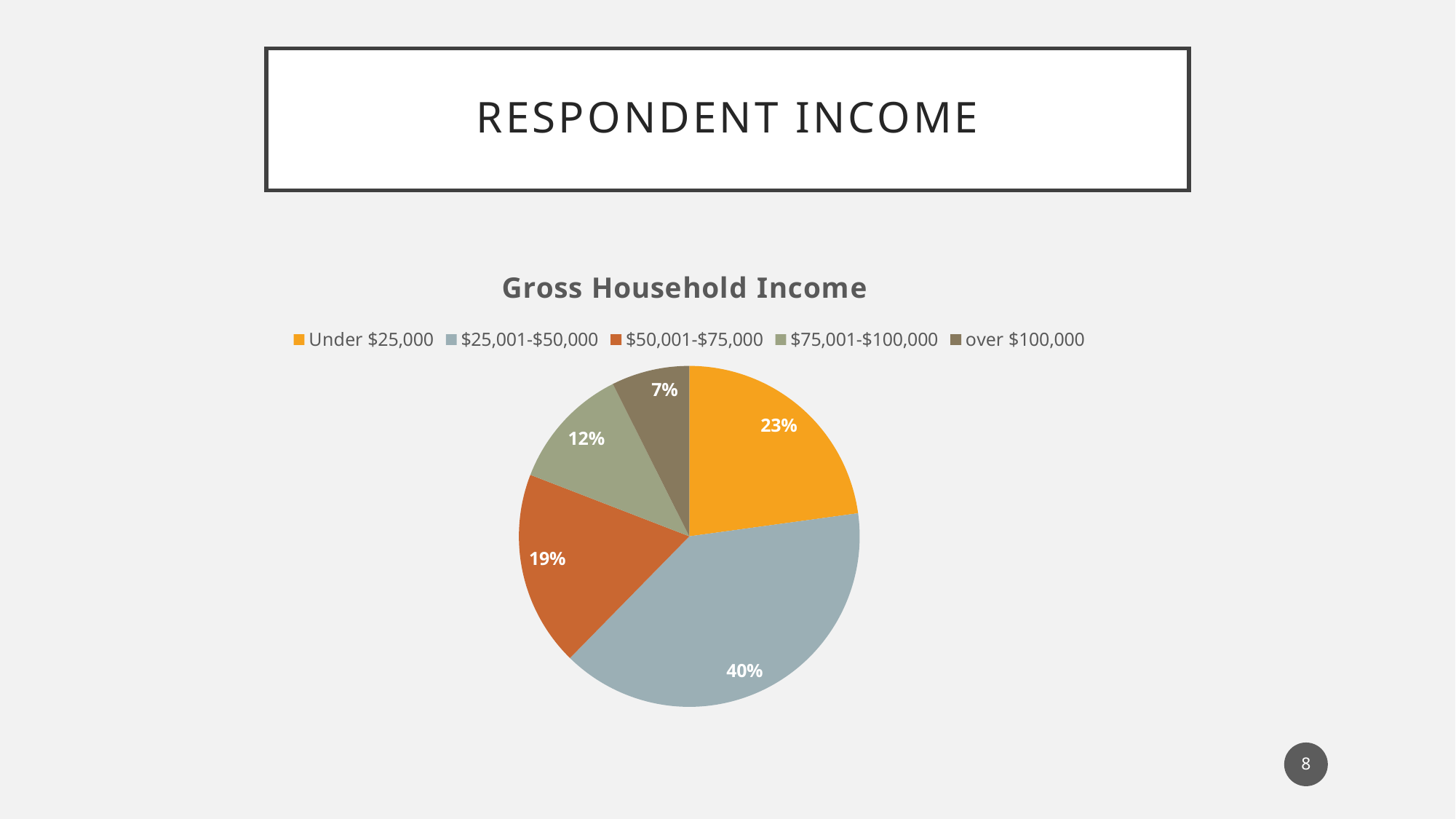
What share of respondents have a gross household income of $25,001-$50,000? 40% What is the difference in percentage points between the $25,001-$50,000 and Under $25,000 slices? 17 Which income bracket has the smallest share of respondents? over $100,000 What share of respondents fall in the $50,001-$75,000 income bracket? 19% What colour is the slice for Under $25,000? Orange What percentage of respondents have a gross household income over $100,000? 7% What is the title of the chart? Gross Household Income How many income brackets are shown in the pie chart? 5 Which income bracket has the largest share of respondents? $25,001-$50,000 What type of chart is used to show Gross Household Income? Pie chart What percentage of respondents earn under $25,000? 23% Which is larger: the share for $50,001-$75,000 or the share for $75,001-$100,000? $50,001-$75,000